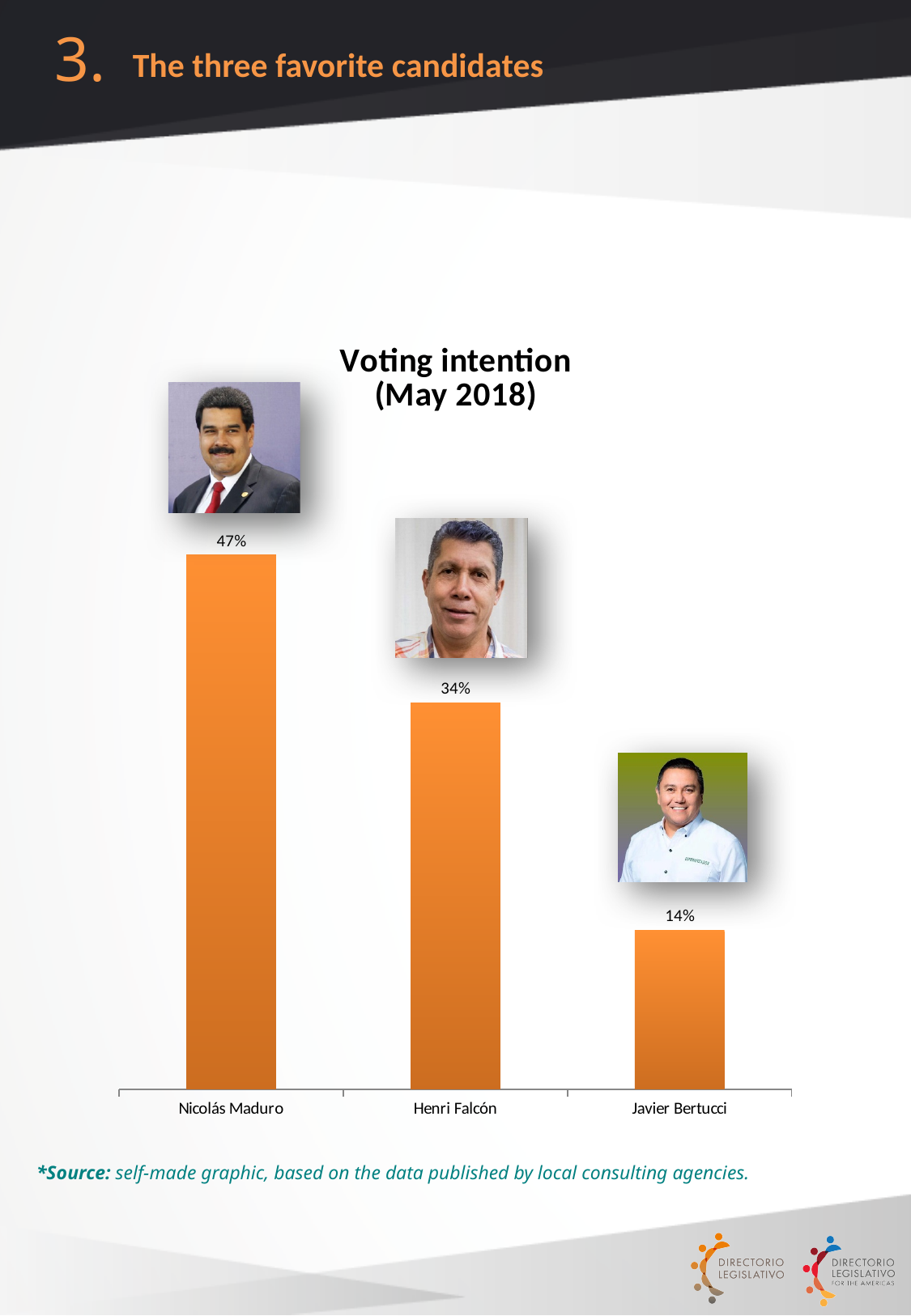
What is the difference in voting intention between Nicolás Maduro and Henri Falcón? 13% Which candidate has the highest voting intention? Nicolás Maduro What is the title of the chart? Voting intention (May 2018) Which candidate has the lowest voting intention? Javier Bertucci What is the voting intention value for Henri Falcón? 34% What is the voting intention value for Nicolás Maduro? 47% What kind of chart is shown on the slide? Bar chart What is the difference in voting intention between Henri Falcón and Javier Bertucci? 20% Do the values rise or fall from left to right across the candidates? Fall How many candidates are shown in the chart? 3 What is the voting intention value for Javier Bertucci? 14% Who has a higher voting intention, Henri Falcón or Javier Bertucci? Henri Falcón